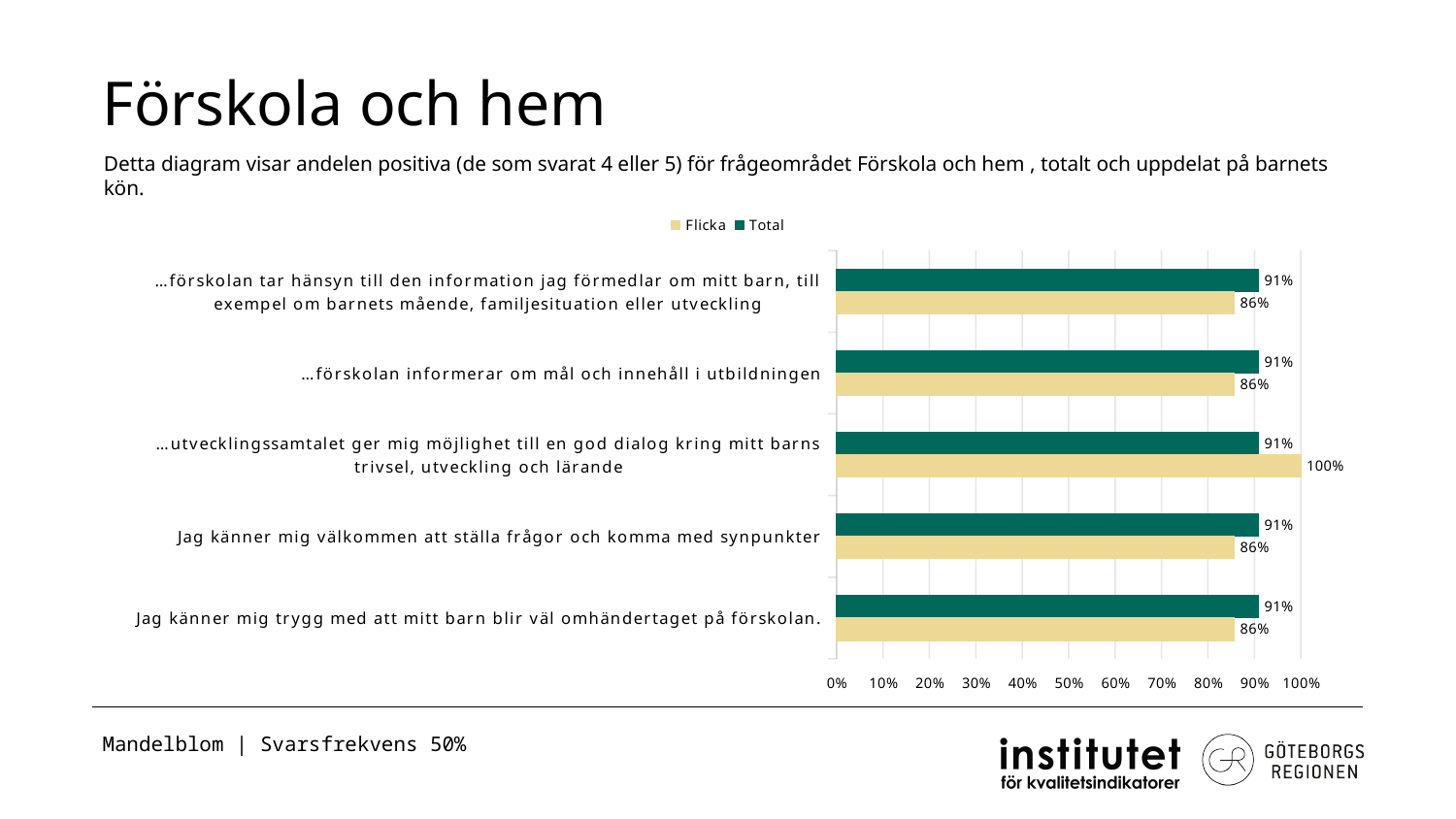
Which series is shown in green? Total How many categories (statements) are shown in the chart? 5 What is the difference between the Flicka and Total values for "…utvecklingssamtalet ger mig möjlighet till en god dialog kring mitt barns trivsel, utveckling och lärande"? 9% What type of chart is shown on the slide? bar chart What is the title of the slide containing the chart? Förskola och hem How many series does the legend list? 2 What is the difference between the Total and Flicka values for "…förskolan tar hänsyn till den information jag förmedlar om mitt barn, till exempel om barnets mående, familjesituation eller utveckling"? 5% What is the Flicka value for "…utvecklingssamtalet ger mig möjlighet till en god dialog kring mitt barns trivsel, utveckling och lärande"? 100% For "Jag känner mig välkommen att ställa frågor och komma med synpunkter", which is larger, the Flicka value or the Total value? Total What is the Flicka value for "…förskolan informerar om mål och innehåll i utbildningen"? 86% What is the Total value for "Jag känner mig trygg med att mitt barn blir väl omhändertaget på förskolan."? 91% Which category has the highest Flicka value? …utvecklingssamtalet ger mig möjlighet till en god dialog kring mitt barns trivsel, utveckling och lärande